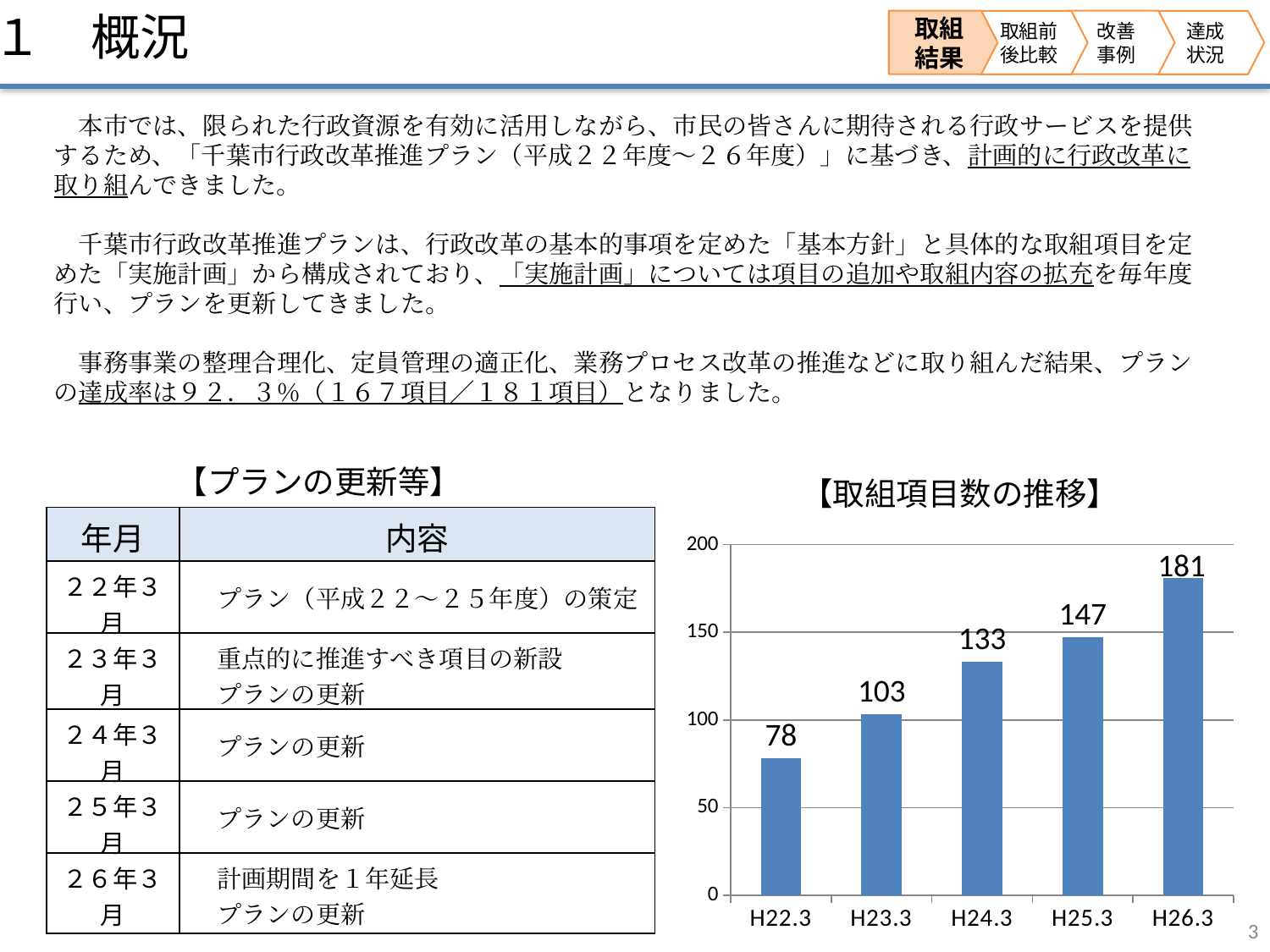
Which is larger in the 【取組項目数の推移】 chart, the value for H24.3 or H25.3? H25.3 What is the value for H24.3 in the 【取組項目数の推移】 chart? 133 What is the value for H22.3 in the 【取組項目数の推移】 chart? 78 What is the difference between the values for H23.3 and H22.3 in the 【取組項目数の推移】 chart? 25 How many categories are shown on the x axis of the 【取組項目数の推移】 chart? 5 Which category has the lowest value in the 【取組項目数の推移】 chart? H22.3 What is the difference between the values for H26.3 and H25.3 in the 【取組項目数の推移】 chart? 34 What is the value for H26.3 in the 【取組項目数の推移】 chart? 181 Do the values in the 【取組項目数の推移】 chart rise or fall from H22.3 to H26.3? rise What kind of chart is the 【取組項目数の推移】 chart? bar chart Which category has the highest value in the 【取組項目数の推移】 chart? H26.3 Is the value for H23.3 in the 【取組項目数の推移】 chart greater or less than 100? greater